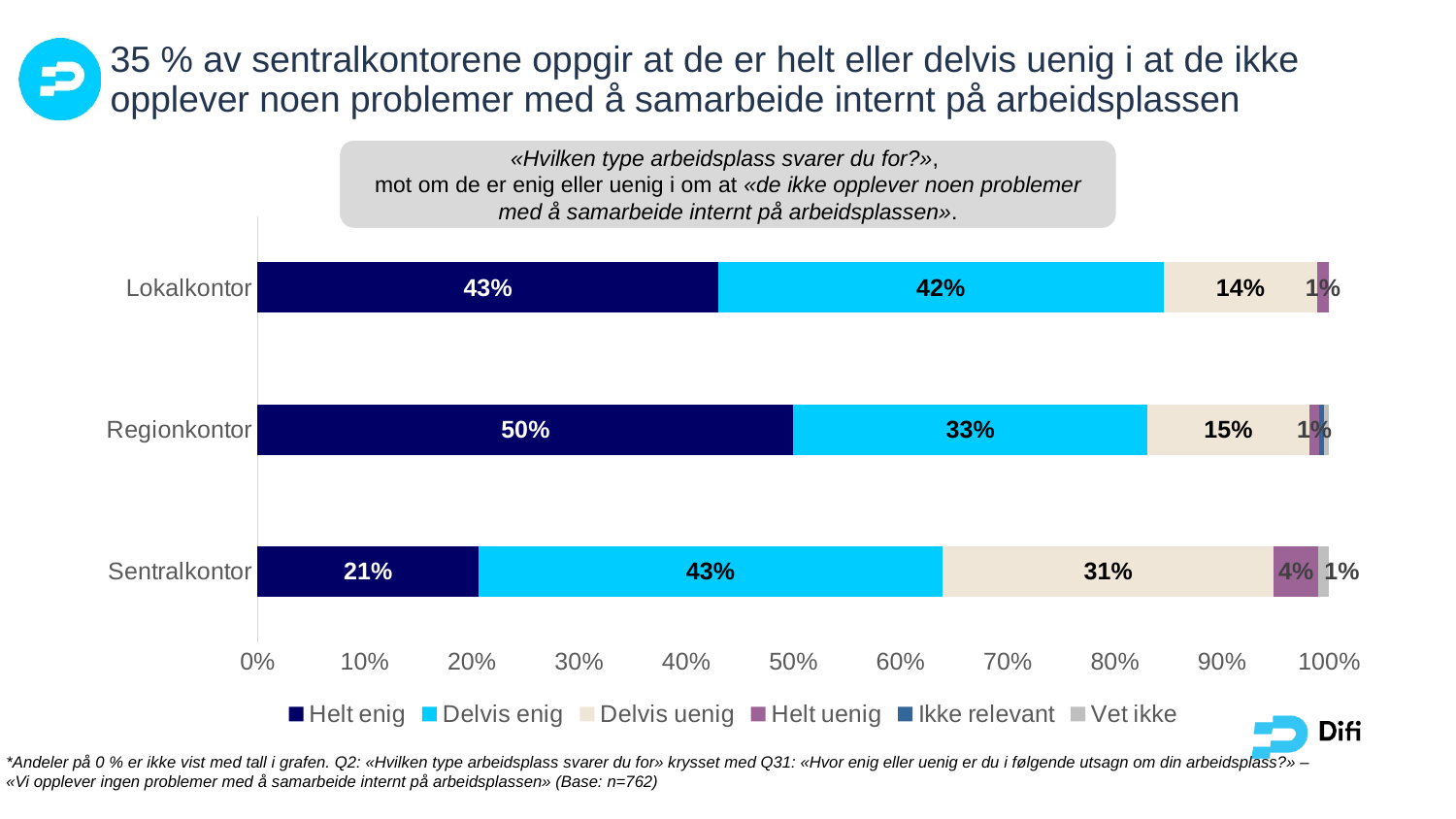
What is the 'Helt uenig' value for Sentralkontor? 4% What is the 'Delvis uenig' value for Lokalkontor? 14% What is the 'Delvis enig' value for Sentralkontor? 43% How many categories (workplace types) are shown on the y axis? 3 What is the difference between the 'Delvis uenig' values for Sentralkontor and Regionkontor? 16% Which category has the highest 'Helt enig' value? Regionkontor Which is larger: the 'Delvis enig' value for Lokalkontor or for Regionkontor? Lokalkontor Which category has the lowest 'Helt enig' value? Sentralkontor What kind of chart is shown on the slide? Stacked bar chart How many series does the legend list? 6 Which legend entry is shown in the darkest blue colour? Helt enig What is the 'Helt enig' value for Regionkontor? 50%